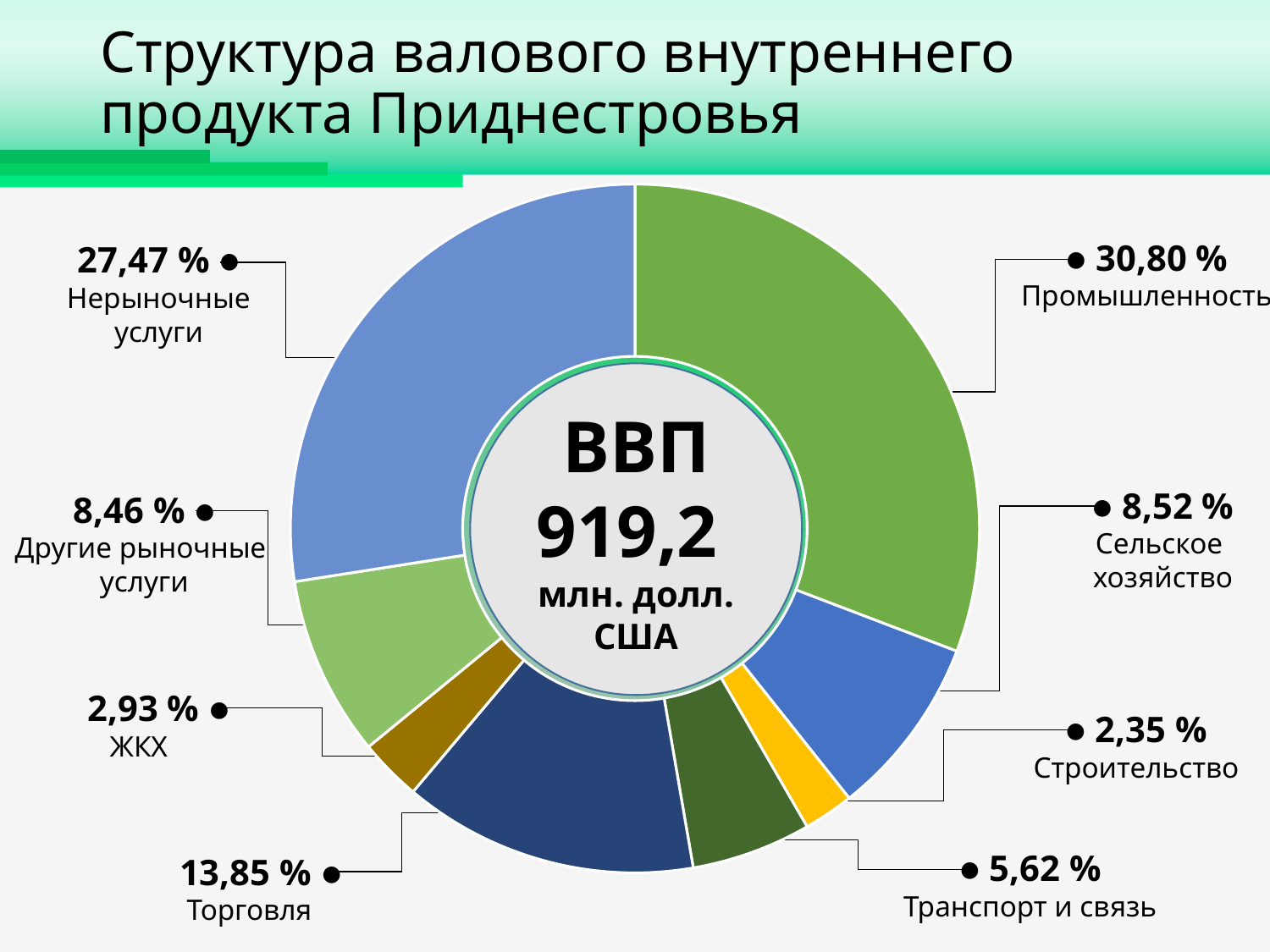
What total GDP value is shown in the centre of the chart? 919,2 млн. долл. США Which is larger, the share of Сельское хозяйство or the share of Другие рыночные услуги? Сельское хозяйство What is the difference in percentage points between the shares of Промышленность and Нерыночные услуги? 3,33 Which sector has the largest share of GDP? Промышленность What share of GDP does Нерыночные услуги account for? 27,47 % How many sectors are shown in the chart? 8 Which sector has the smallest share of GDP? Строительство What share of GDP does Торговля account for? 13,85 % What share of GDP does Промышленность account for? 30,80 % What share of GDP does Транспорт и связь account for? 5,62 % What kind of chart is shown on the slide? Pie (doughnut) chart What is the difference in percentage points between the shares of Торговля and Транспорт и связь? 8,23